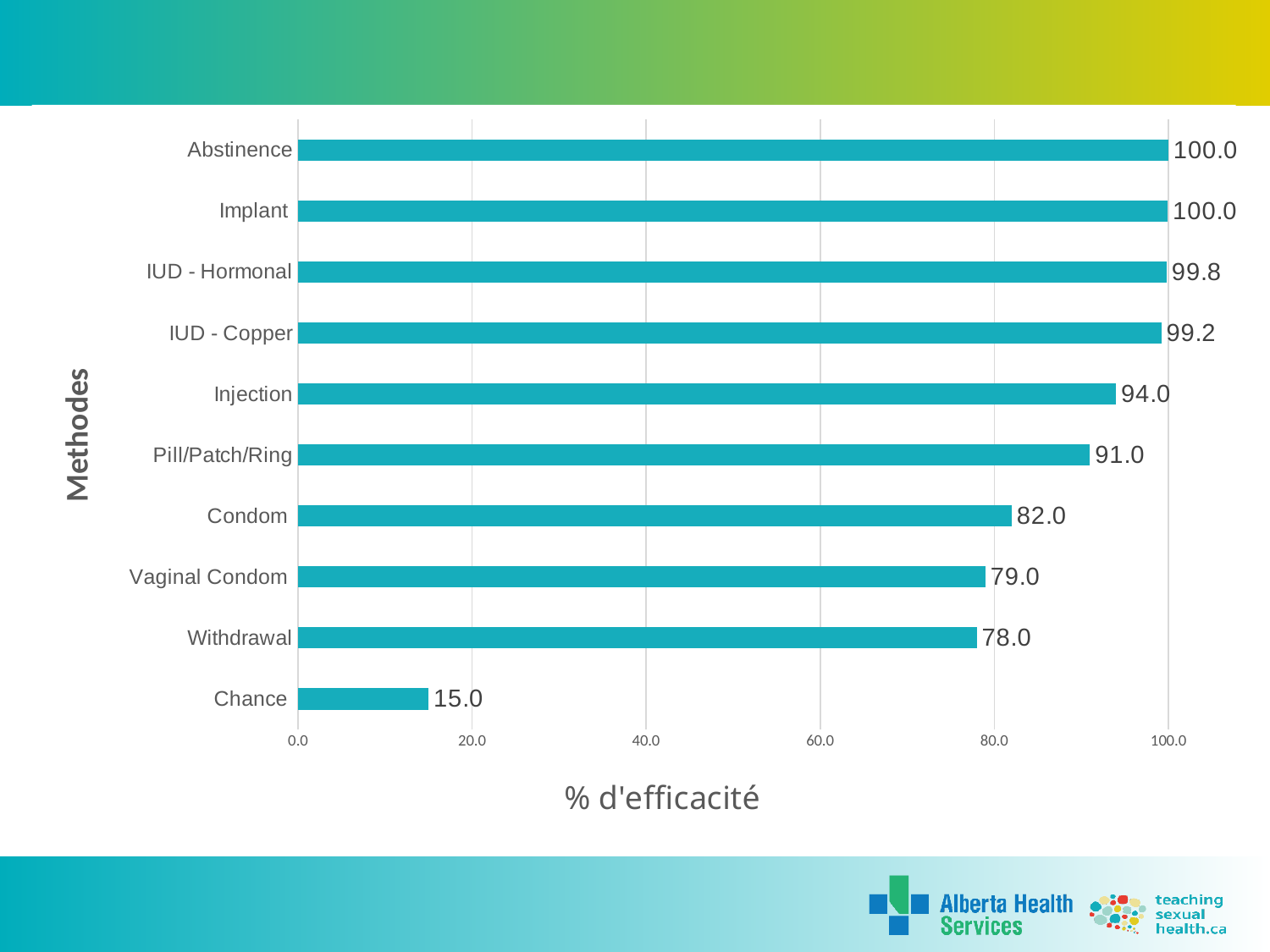
What is the value for IUD - Copper? 99.2 What is the label of the horizontal axis? % d'efficacité What is the difference between the values for Pill/Patch/Ring and Withdrawal? 13.0 What kind of chart is shown on the slide? bar chart What is the label of the vertical axis? Methodes Which category has the lowest value? Chance How many categories are shown on the chart? 10 Is the value for Withdrawal greater or less than 80.0? less What is the value for Injection? 94.0 Which is larger, the value for Condom or the value for Vaginal Condom? Condom What is the difference between the values for Abstinence and Chance? 85.0 What is the value for Condom? 82.0